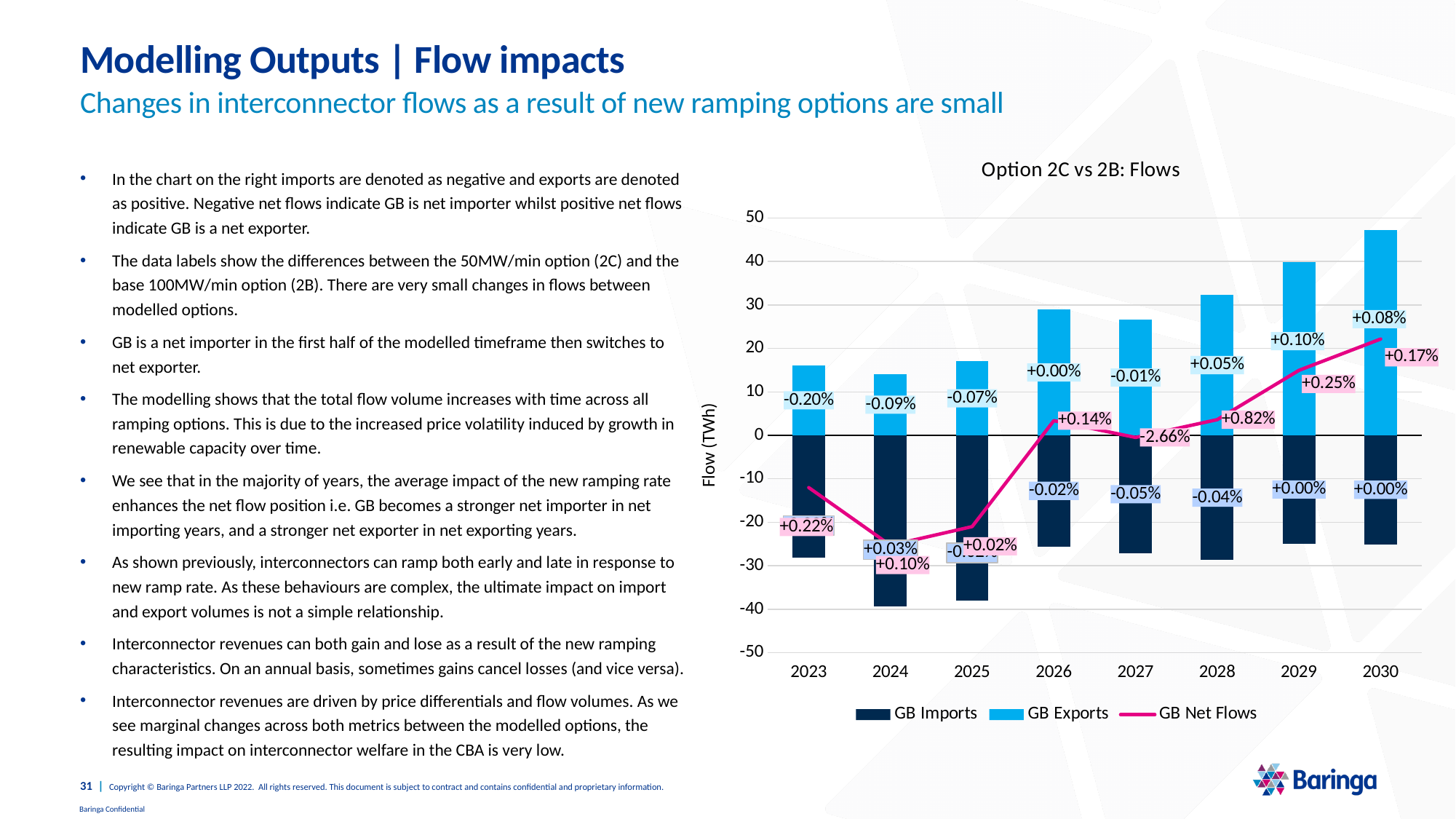
Is the GB Exports value for 2030 greater or less than 40? greater What data label is shown on the GB Exports bar for 2029? +0.10% What data label is shown on the GB Exports bar for 2023? -0.20% Do the GB Exports bars rise or fall from 2026 to 2030? rise Is the GB Imports value for 2024 greater or less than -30? less How many years are shown on the x axis of the chart? 8 How many series does the chart legend list? 3 What data label is shown on the GB Imports bar for 2027? -0.05% What data label is shown on the GB Net Flows line for 2027? -2.66% What is the title of the chart? Option 2C vs 2B: Flows What is the label on the vertical axis of the chart? Flow (TWh) Which year has the tallest GB Exports bar? 2030